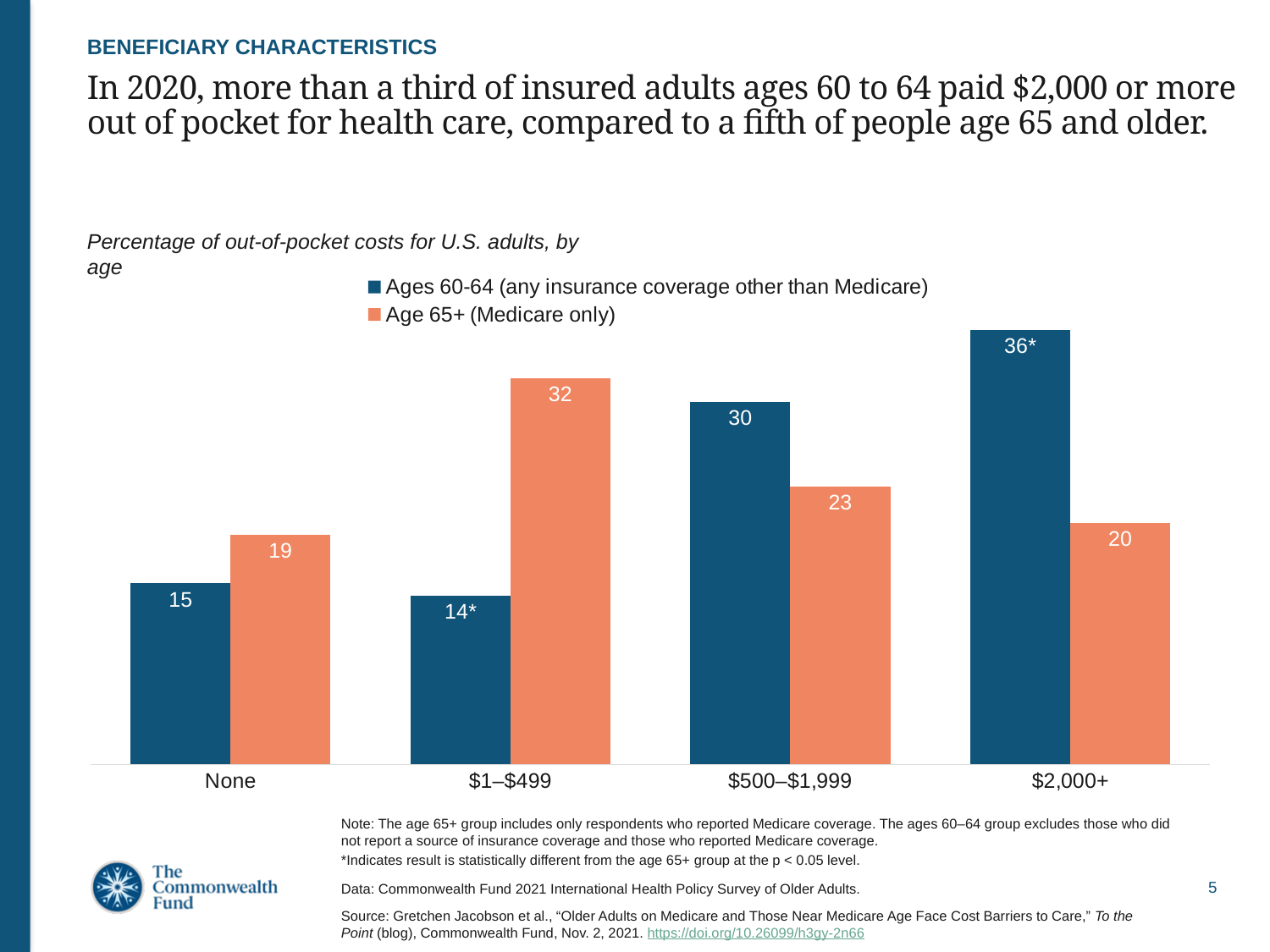
Which category has the lowest value for Age 65+ (Medicare only)? None What is the value for Ages 60-64 (any insurance coverage other than Medicare) in the $2,000+ category? 36* What is the value for Age 65+ (Medicare only) in the None category? 19 What kind of chart is shown on the slide? Bar chart How many series does the legend list? 2 Which category has the highest value for Ages 60-64 (any insurance coverage other than Medicare)? $2,000+ How many out-of-pocket cost categories are shown on the x axis? 4 What is the value for Age 65+ (Medicare only) in the $1–$499 category? 32 What is the subtitle of the chart? Percentage of out-of-pocket costs for U.S. adults, by age What is the difference between the Ages 60-64 and Age 65+ values in the $2,000+ category? 16 In the $1–$499 category, which series has the larger value: Ages 60-64 or Age 65+? Age 65+ (Medicare only) What is the value for Ages 60-64 (any insurance coverage other than Medicare) in the $500–$1,999 category? 30